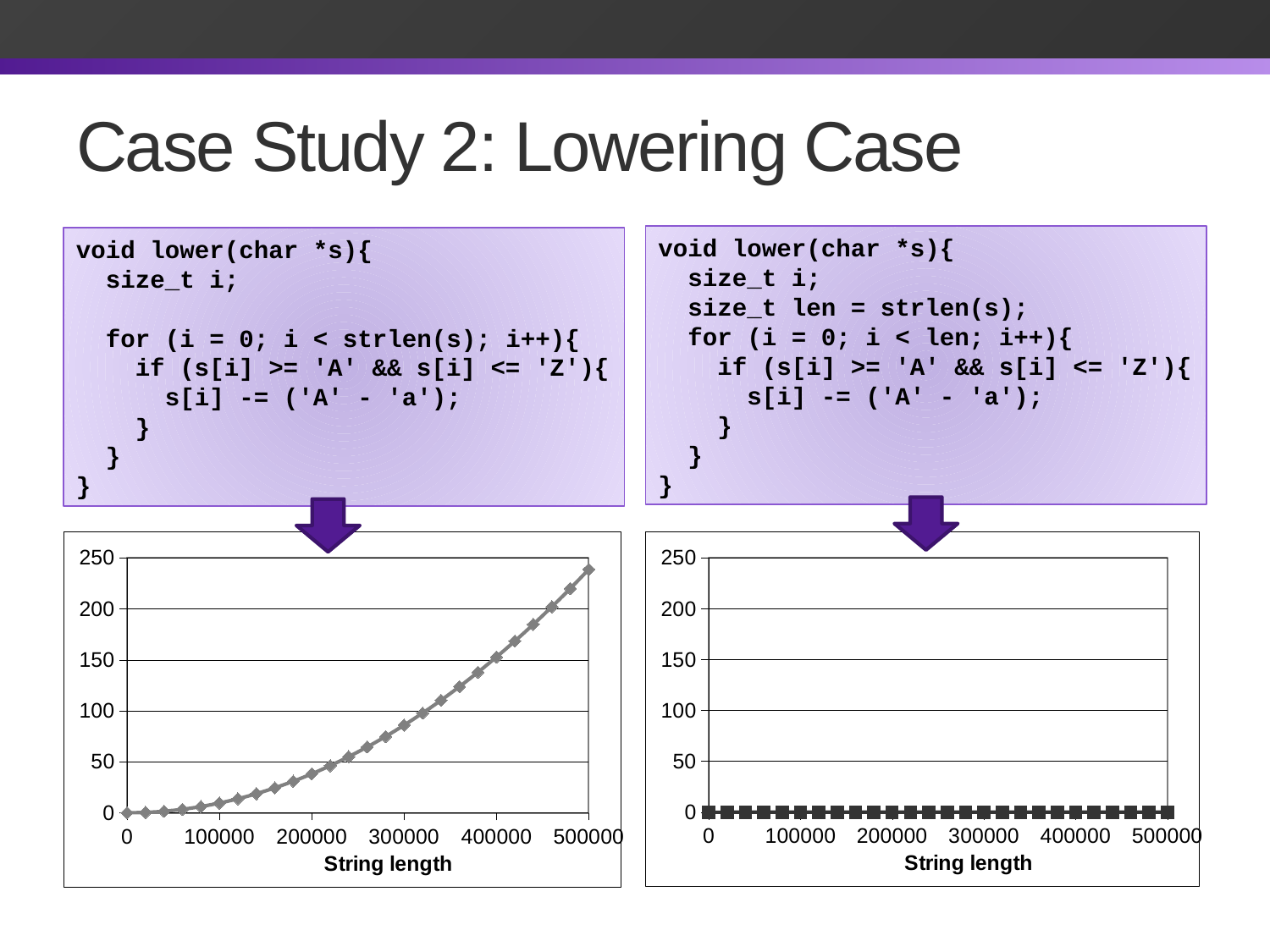
In the chart on the left, is the value at string length 100000 greater or less than 50? less In the chart on the right, do the values rise, fall, or stay flat as string length increases? stay flat In the chart on the left, do the values rise or fall as string length increases? rise In the chart on the left, at which string length is the plotted value highest? 500000 In the chart on the left, is the value at string length 500000 greater or less than 200? greater What kind of chart is the chart on the left of the slide? line chart What kind of chart is the chart on the right of the slide? line chart In the chart on the right, is the value at string length 500000 greater or less than 50? less In the chart on the left, at which string length is the plotted value lowest? 0 What is the maximum value shown on the y-axis of the chart on the right? 250 At string length 500000, which chart shows the larger value, the left chart or the right chart? the left chart What is the x-axis label of the chart on the left? String length